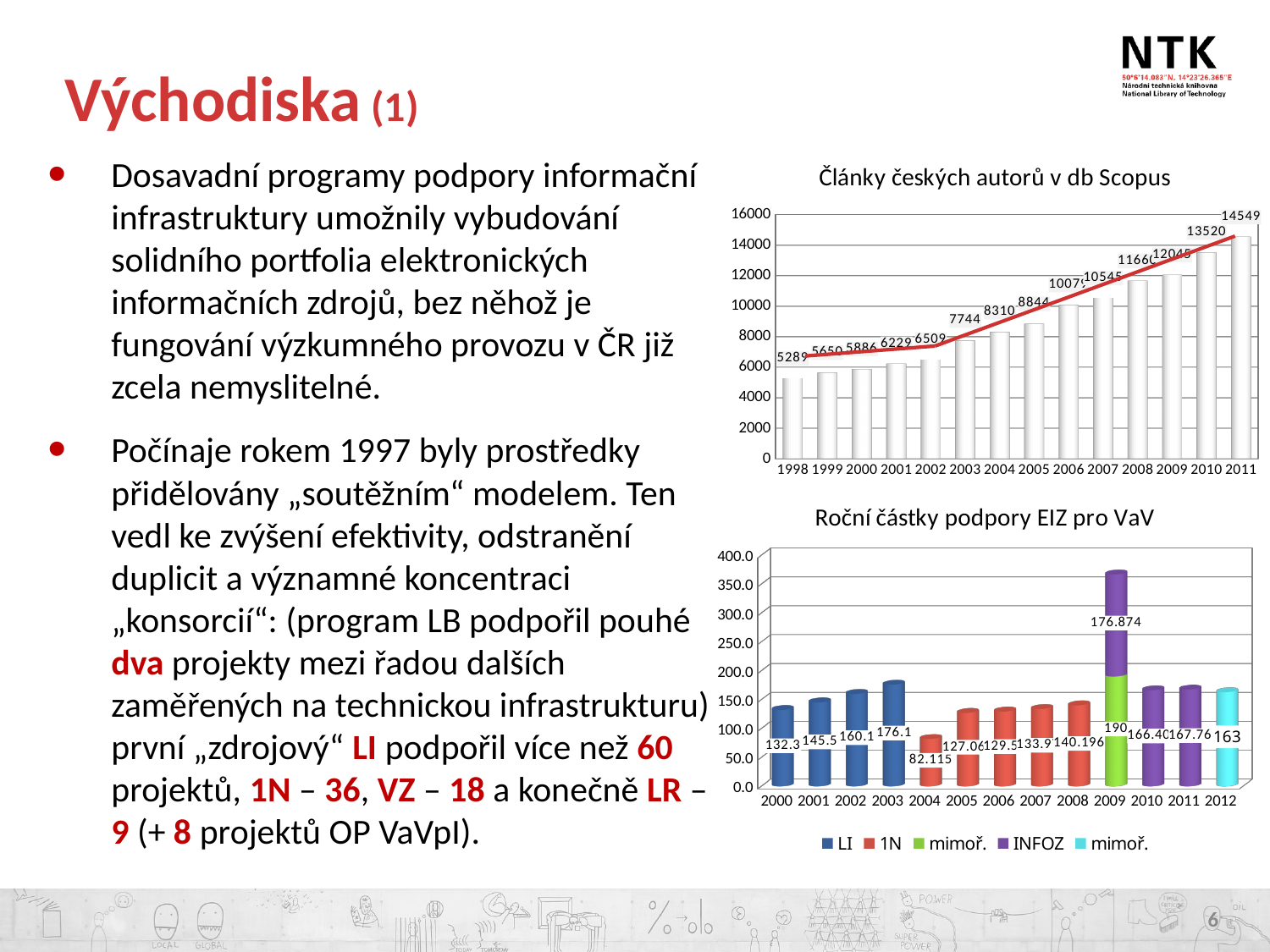
What kind of chart is 'Články českých autorů v db Scopus'? bar chart In the chart 'Články českých autorů v db Scopus', which year has the highest value? 2011 In the chart 'Články českých autorů v db Scopus', do the values rise or fall from 1998 to 2011? rise How many years are shown on the x axis of the chart 'Články českých autorů v db Scopus'? 14 In the chart 'Články českých autorů v db Scopus', what is the value for 1998? 5289 In the chart 'Články českých autorů v db Scopus', what is the value for 2011? 14549 In the chart 'Roční částky podpory EIZ pro VaV', what is the value for 2004? 82.115 How many series does the legend of the chart 'Roční částky podpory EIZ pro VaV' list? 5 In the chart 'Roční částky podpory EIZ pro VaV', what is the total of the stacked bar for 2009? 366.874 In the chart 'Roční částky podpory EIZ pro VaV', which year has the lowest value? 2004 In the chart 'Roční částky podpory EIZ pro VaV', what is the difference between the values for 2003 and 2000? 43.8 In the chart 'Články českých autorů v db Scopus', what is the difference between the values for 2011 and 2010? 1029